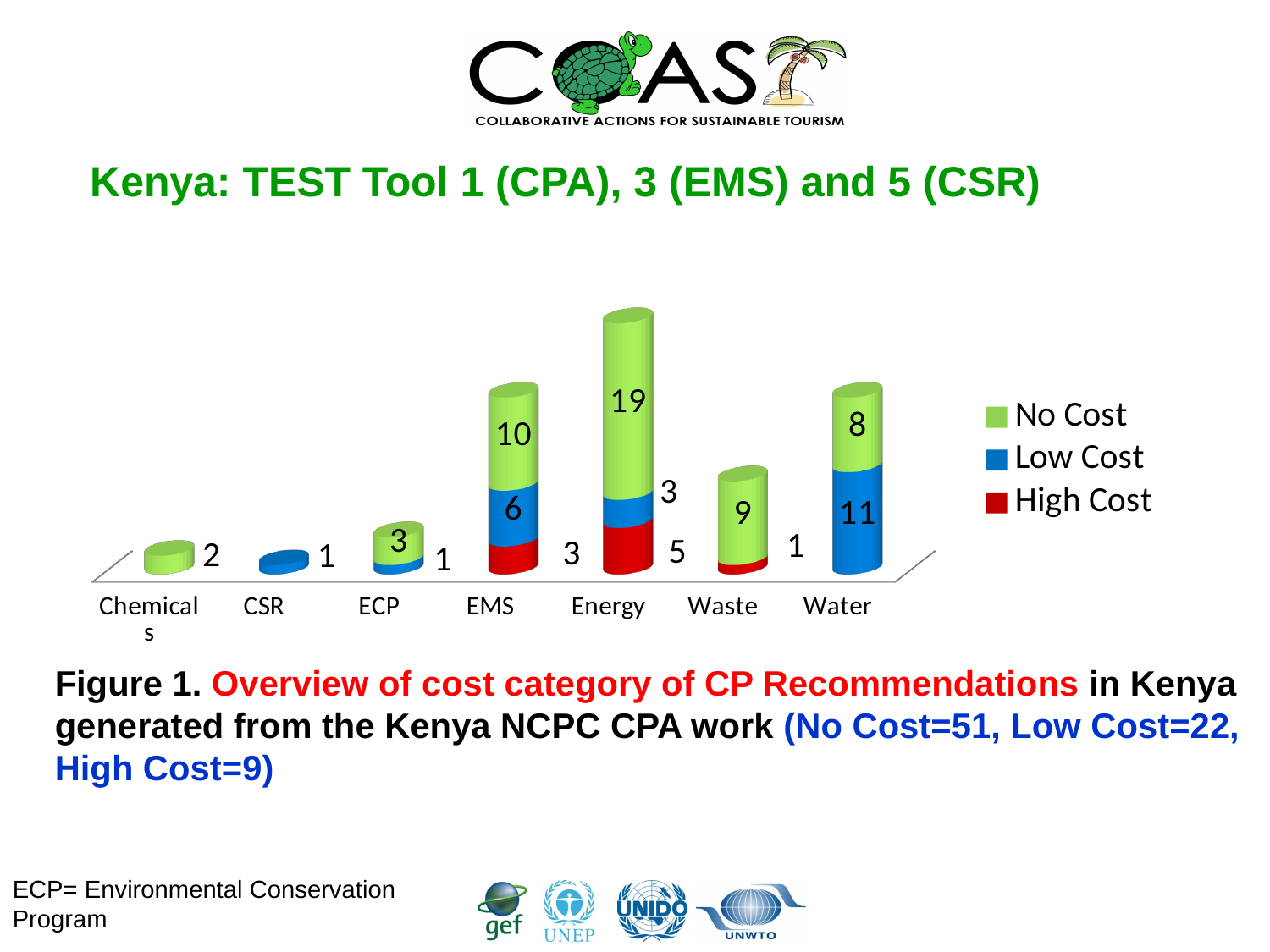
What is the No Cost value for Energy? 19 How many categories are shown on the x axis? 7 What is the total of the stacked bar for Energy? 27 Which category has the highest No Cost value? Energy What is the No Cost value for Waste? 9 What is the difference between the No Cost values for Energy and EMS? 9 Which category has the lowest High Cost value among those with a High Cost segment? Waste What kind of chart is shown on the slide? Stacked bar chart What is the Low Cost value for Water? 11 What is the High Cost value for EMS? 3 Which is larger, the Low Cost value for Water or the Low Cost value for EMS? Water How many series does the legend list? 3